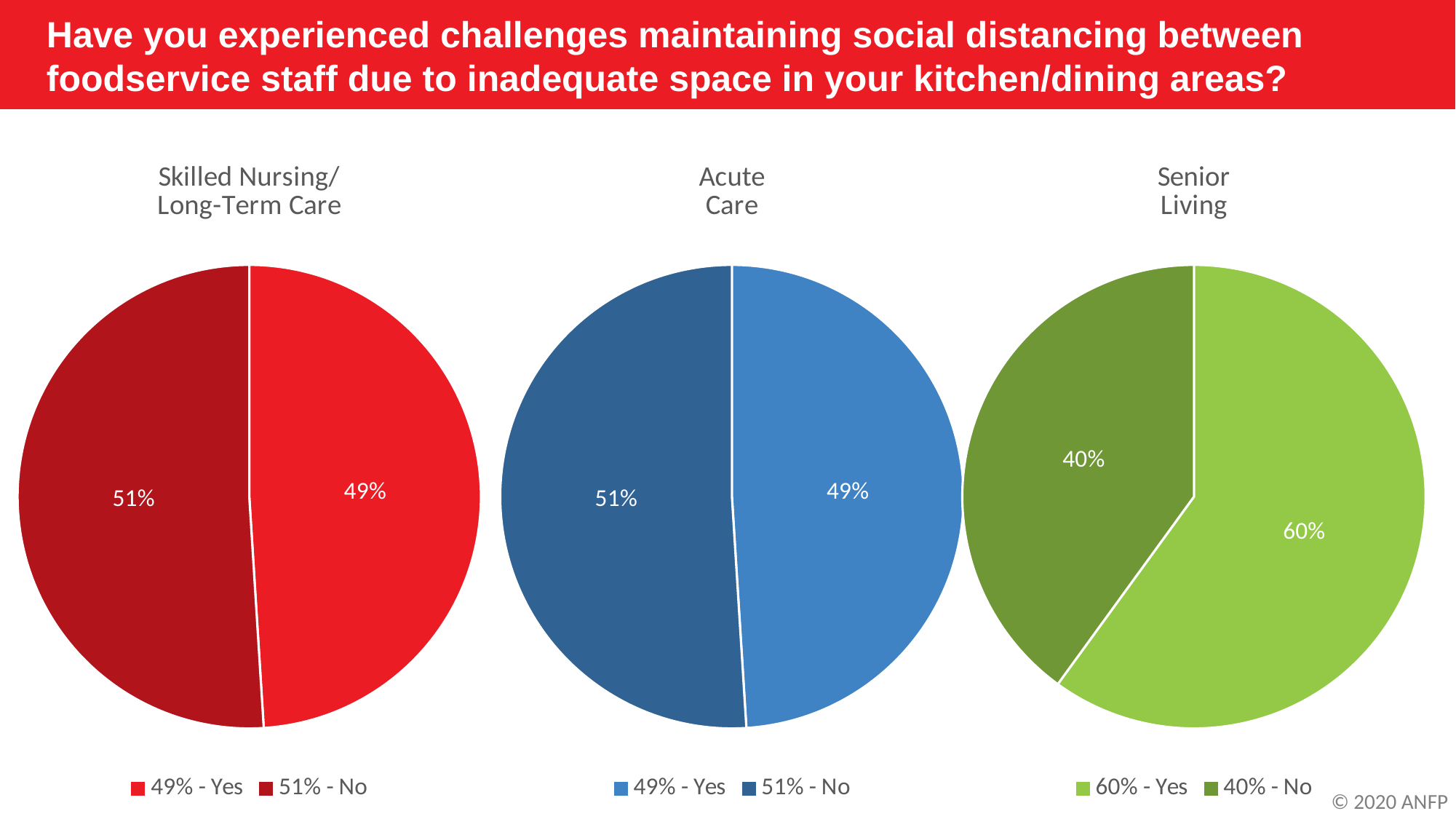
What kind of chart is used for the Senior Living data? Pie chart In the Senior Living chart, which response has the larger share, Yes or No? Yes In the Skilled Nursing/Long-Term Care chart, what percentage answered No? 51% In the Senior Living chart, what percentage answered Yes? 60% In the Acute Care chart, what colour is the Yes slice? Light blue In the Skilled Nursing/Long-Term Care chart, what percentage answered Yes? 49% How many entries does the legend of the Acute Care chart list? 2 In the Acute Care chart, what percentage answered Yes? 49% In the Senior Living chart, what is the difference between the Yes and No shares? 20% In the Acute Care chart, what is the difference between the No and Yes shares? 2% How many pie charts are shown on the slide? 3 In the Senior Living chart, what percentage answered No? 40%